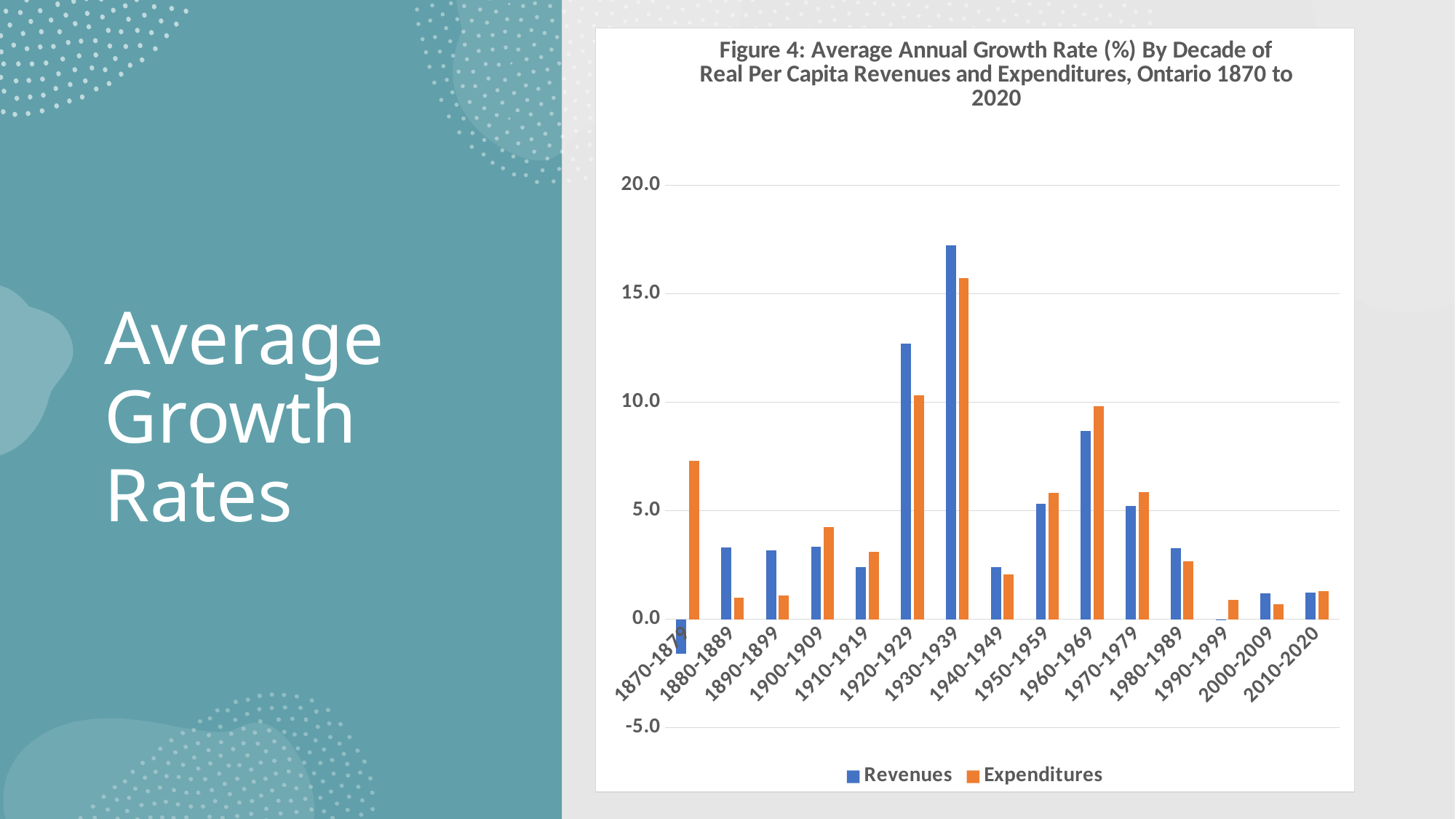
Which decade has the highest Revenues growth rate? 1930-1939 Which decade has the lowest Revenues growth rate? 1870-1879 Is the Revenues value for 1960-1969 greater or less than 10.0? less Which decade has the highest Expenditures growth rate? 1930-1939 In 1870-1879, which is larger, Revenues or Expenditures? Expenditures How many decade categories are shown on the x axis? 15 In 1920-1929, which is larger, Revenues or Expenditures? Revenues Is the Expenditures value for 1870-1879 greater or less than 5.0? greater How many series does the legend list? 2 What kind of chart is shown on the slide? Bar chart Do the Revenues values rise or fall from 1960-1969 to 1990-1999? fall Is the Revenues value for 1930-1939 greater or less than 15.0? greater